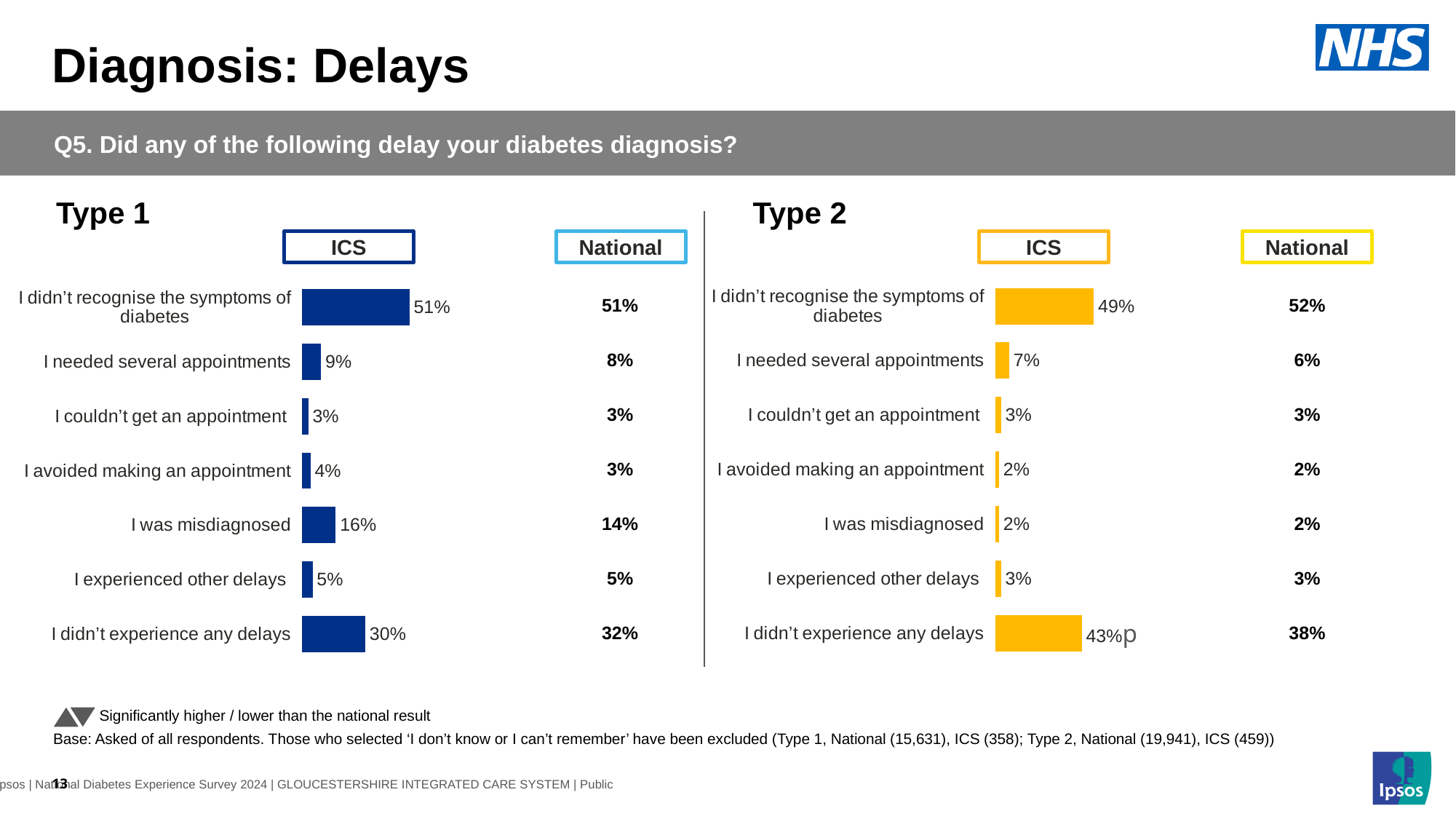
What type of chart is used for the ICS values in the Type 2 chart? bar chart In the Type 1 chart, what is the difference between the ICS and National values for 'I was misdiagnosed'? 2 percentage points In the Type 2 chart, what is the ICS value for 'I didn't experience any delays'? 43% In the Type 2 chart, which category has the lowest National value? I avoided making an appointment and I was misdiagnosed (both 2%) In the Type 2 chart, what is the National value for 'I didn't recognise the symptoms of diabetes'? 52% In the Type 1 chart, which category has the highest ICS value? I didn't recognise the symptoms of diabetes In the Type 1 chart, what is the National value for 'I didn't experience any delays'? 32% In the Type 2 chart, what is the difference between the National and ICS values for 'I didn't experience any delays'? 5 percentage points In the Type 1 chart, is the ICS value for 'I needed several appointments' larger or smaller than the National value? larger In the Type 1 chart, what is the ICS value for 'I was misdiagnosed'? 16% In the Type 2 chart, is the ICS value for 'I didn't recognise the symptoms of diabetes' larger or smaller than the National value? smaller How many categories are shown in the Type 1 chart? 7